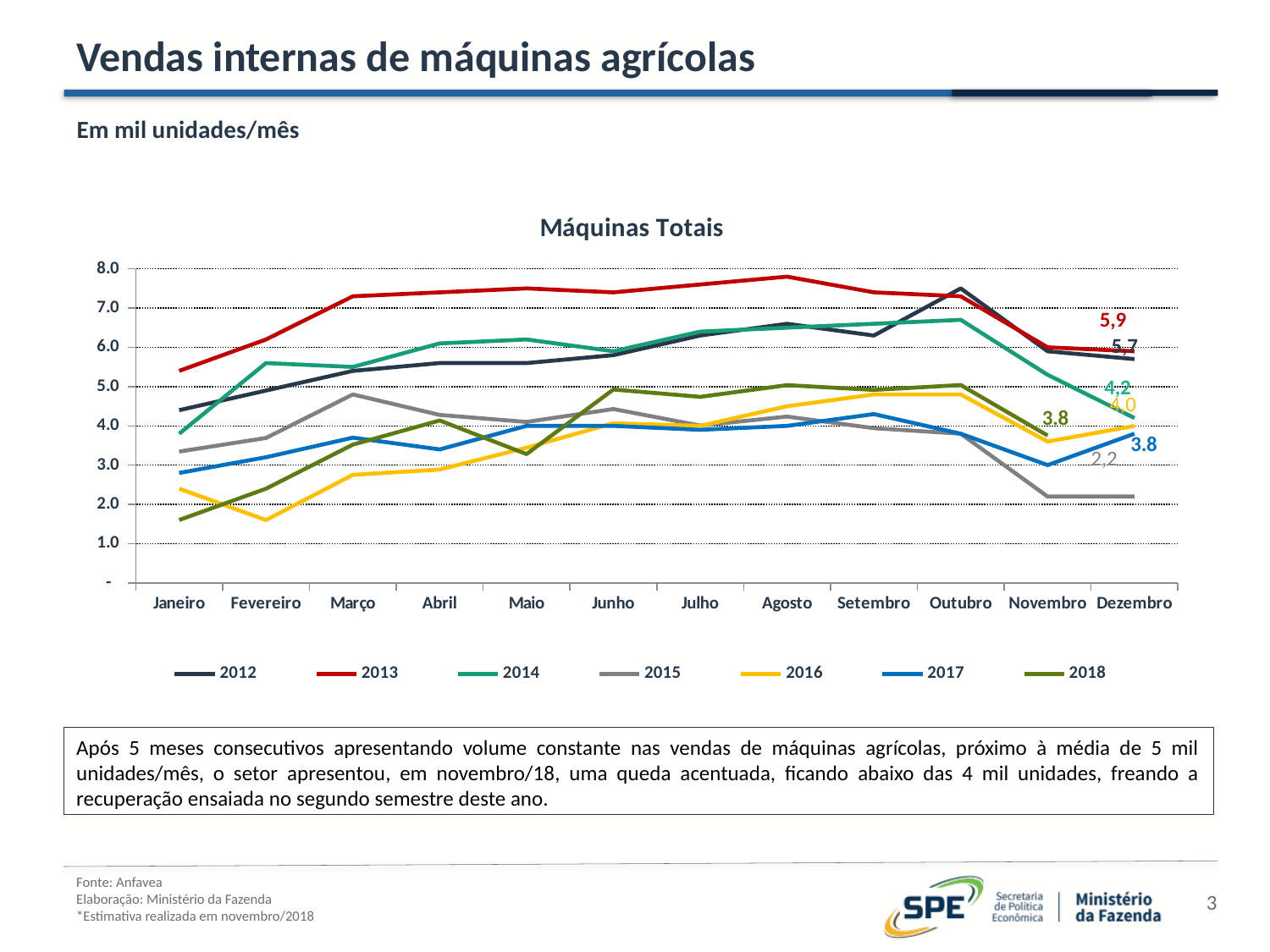
Is the value for 2015 in Novembro greater or less than 3.0? less Which series has the highest value in Agosto? 2013 What kind of chart is shown on the slide? line chart In Dezembro, which series has the larger value, 2014 or 2016? 2014 How many series does the legend of the 'Máquinas Totais' chart list? 7 What is the difference between the Dezembro values for 2013 and 2012? 0,2 Which series has the lowest value in Janeiro? 2018 Is the value for 2013 in Agosto greater or less than 7.0? greater What is the value for 2012 in Dezembro? 5,7 What is the value for 2013 in Dezembro? 5,9 What is the value for 2015 in Dezembro? 2,2 How many months are shown on the x axis of the chart? 12